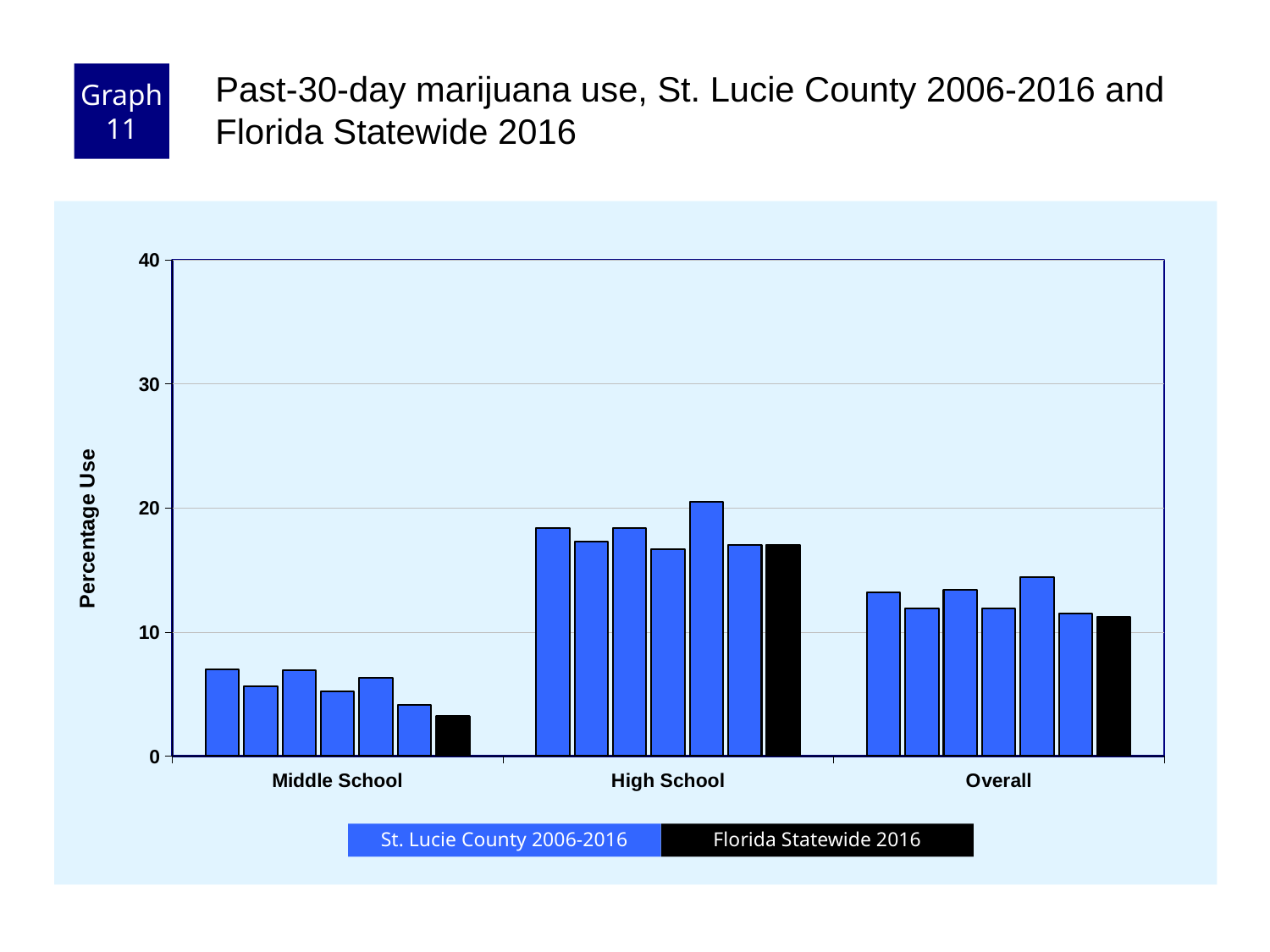
What is the label on the y axis? Percentage Use Which category has the lowest bars overall? Middle School Which is larger, the Florida Statewide 2016 value for High School or for Overall? High School Is the Florida Statewide 2016 value for High School greater or less than 20? less Is the Florida Statewide 2016 value for High School greater or less than 10? greater Which category has the highest bars overall? High School How many series does the legend list? 2 Is the Florida Statewide 2016 value for Middle School greater or less than 10? less What kind of chart is shown on the slide? bar chart Which colour represents Florida Statewide 2016 in the legend? black How many categories are shown along the x axis? 3